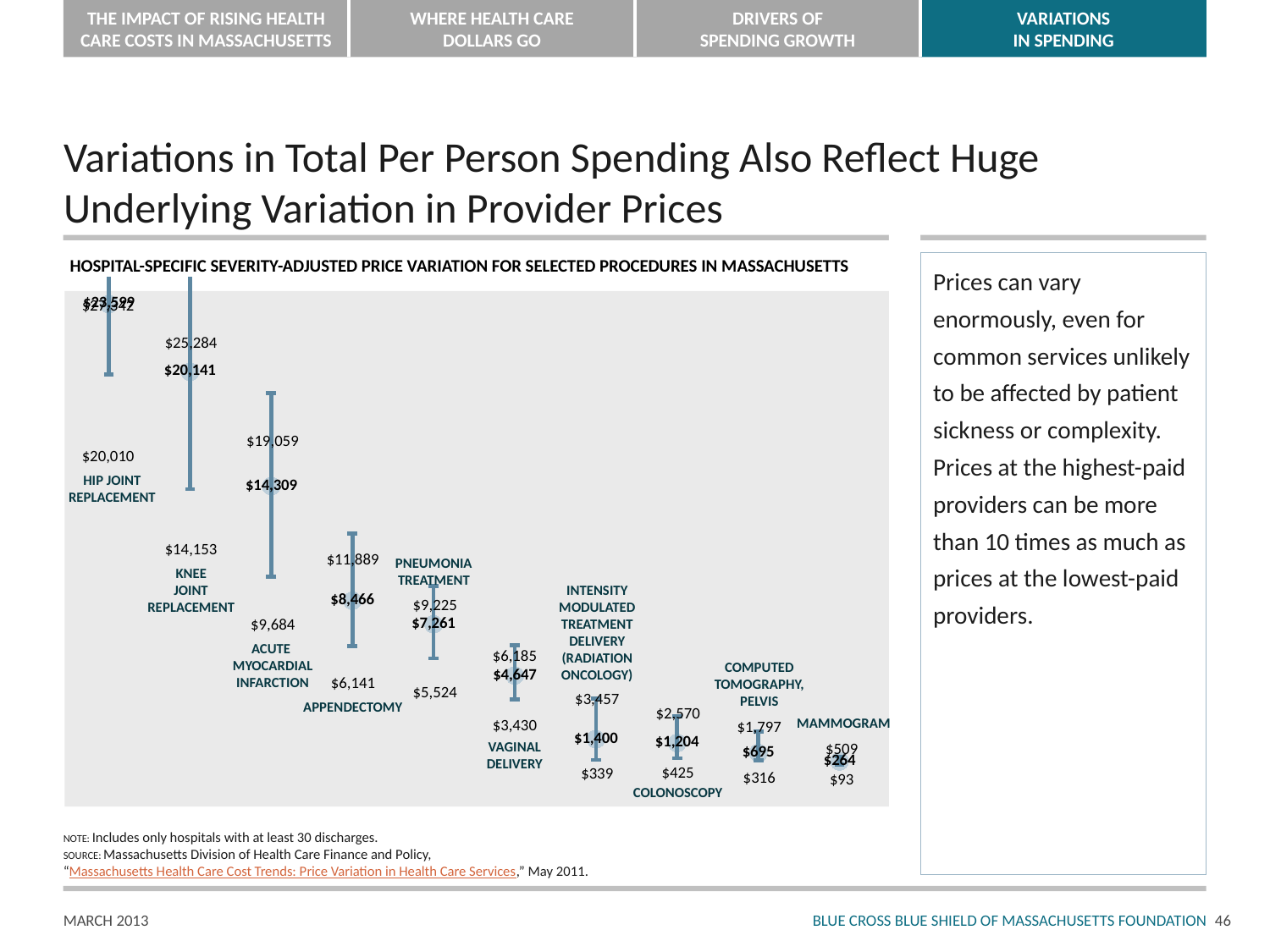
What is the lowest price shown for Mammogram? $93 What is the title of the chart? Hospital-Specific Severity-Adjusted Price Variation for Selected Procedures in Massachusetts What is the difference between the highest and lowest prices shown for Intensity Modulated Treatment Delivery (Radiation Oncology)? $3,118 Which procedure has the lowest bold (median) price on the chart? Mammogram What is the bold (median) price shown for Acute Myocardial Infarction? $14,309 What is the highest price shown for Knee Joint Replacement? $25,284 What is the lowest price shown for Hip Joint Replacement? $20,010 What is the highest price shown for Colonoscopy? $2,570 How many procedures are shown on the chart? 10 Which is larger: the highest price for Pneumonia Treatment or the highest price for Vaginal Delivery? Pneumonia Treatment What is the bold (median) price shown for Computed Tomography, Pelvis? $695 What is the difference between the highest and lowest prices shown for Appendectomy? $5,748